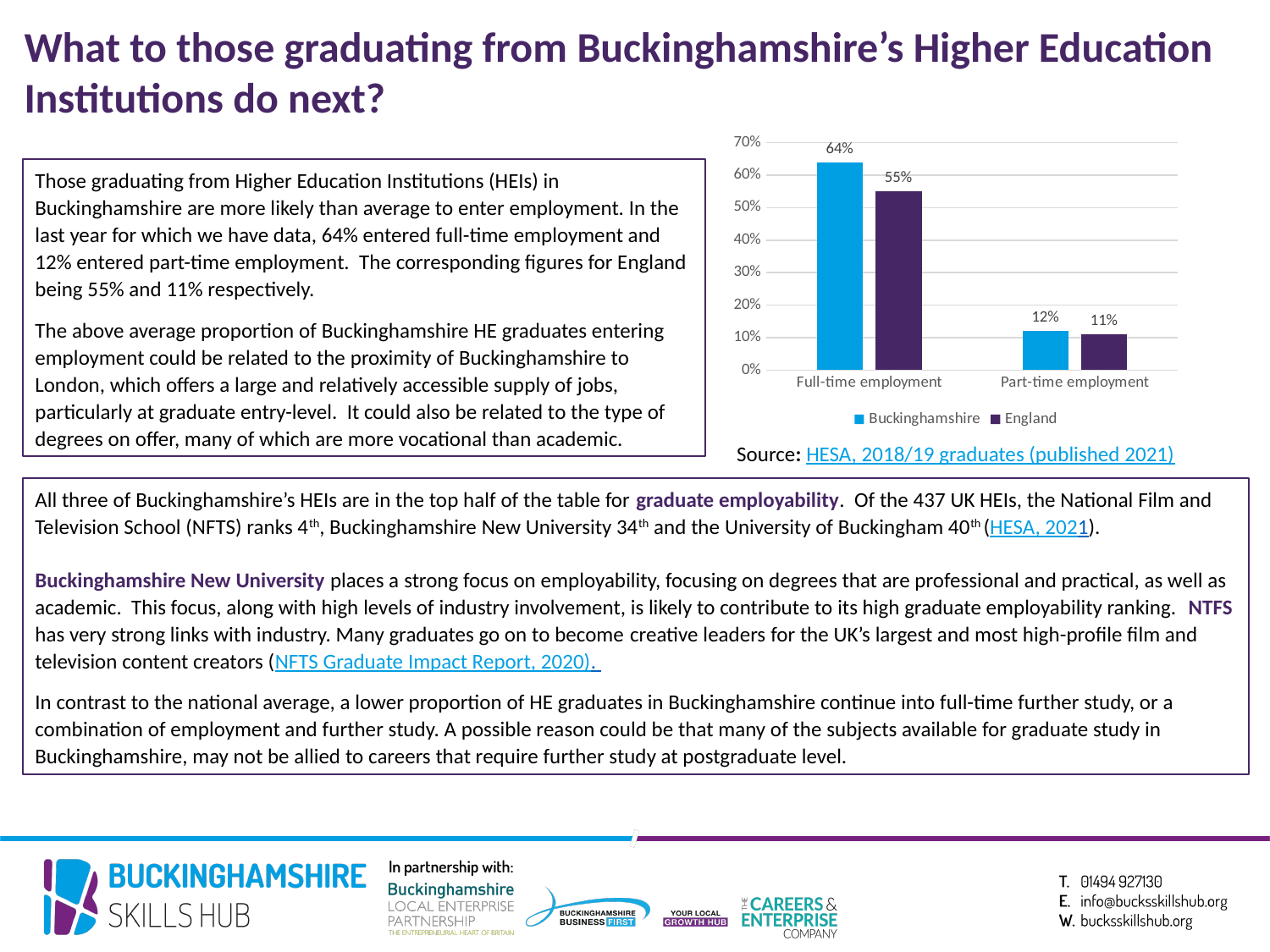
Which is larger for part-time employment, Buckinghamshire or England? Buckinghamshire What percentage of Buckinghamshire HE graduates entered full-time employment? 64% What is the value for England for full-time employment? 55% Which series is shown in light blue in the chart? Buckinghamshire What is the value for Buckinghamshire for part-time employment? 12% What kind of chart is shown on the slide? Bar chart How many categories are shown on the x axis of the chart? 2 Which category has the lowest value for England? Part-time employment What is the value for England for part-time employment? 11% Which category has the highest value for Buckinghamshire? Full-time employment How many series does the chart legend list? 2 What is the difference between the Buckinghamshire and England values for full-time employment? 9%